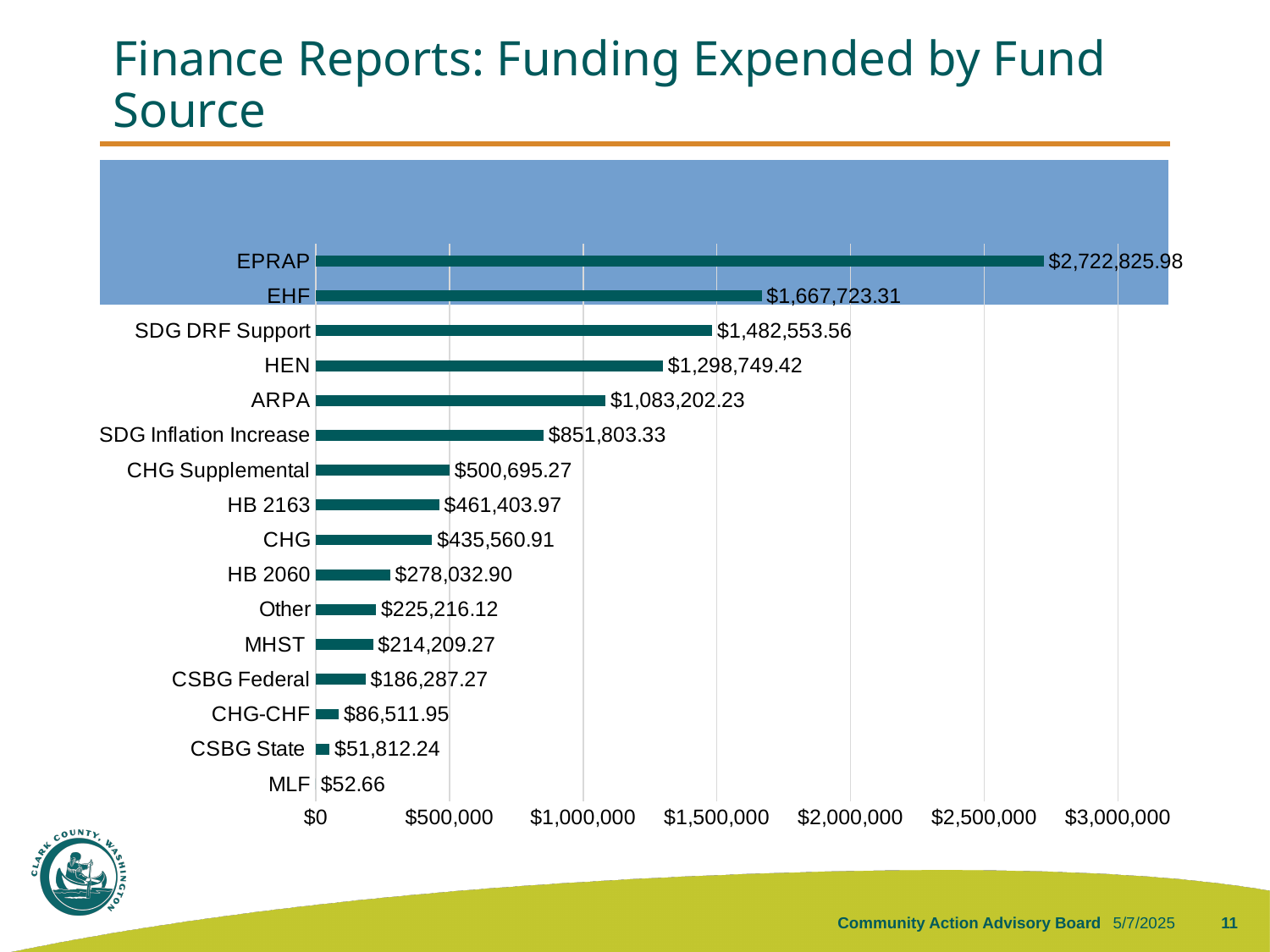
What is the difference between the values for HB 2163 and CHG? $25,843.06 Which fund source has the lowest funding expended? MLF Is the value for SDG Inflation Increase greater or less than $1,000,000? less What is the value for EPRAP? $2,722,825.98 Which fund source has the highest funding expended? EPRAP What kind of chart is shown on the slide? Bar chart How many fund sources are shown in the chart? 16 What is the value for SDG DRF Support? $1,482,553.56 What is the value for CHG Supplemental? $500,695.27 What is the difference between the values for EPRAP and EHF? $1,055,102.67 What is the value for MLF? $52.66 Which is larger, the value for HEN or the value for ARPA? HEN